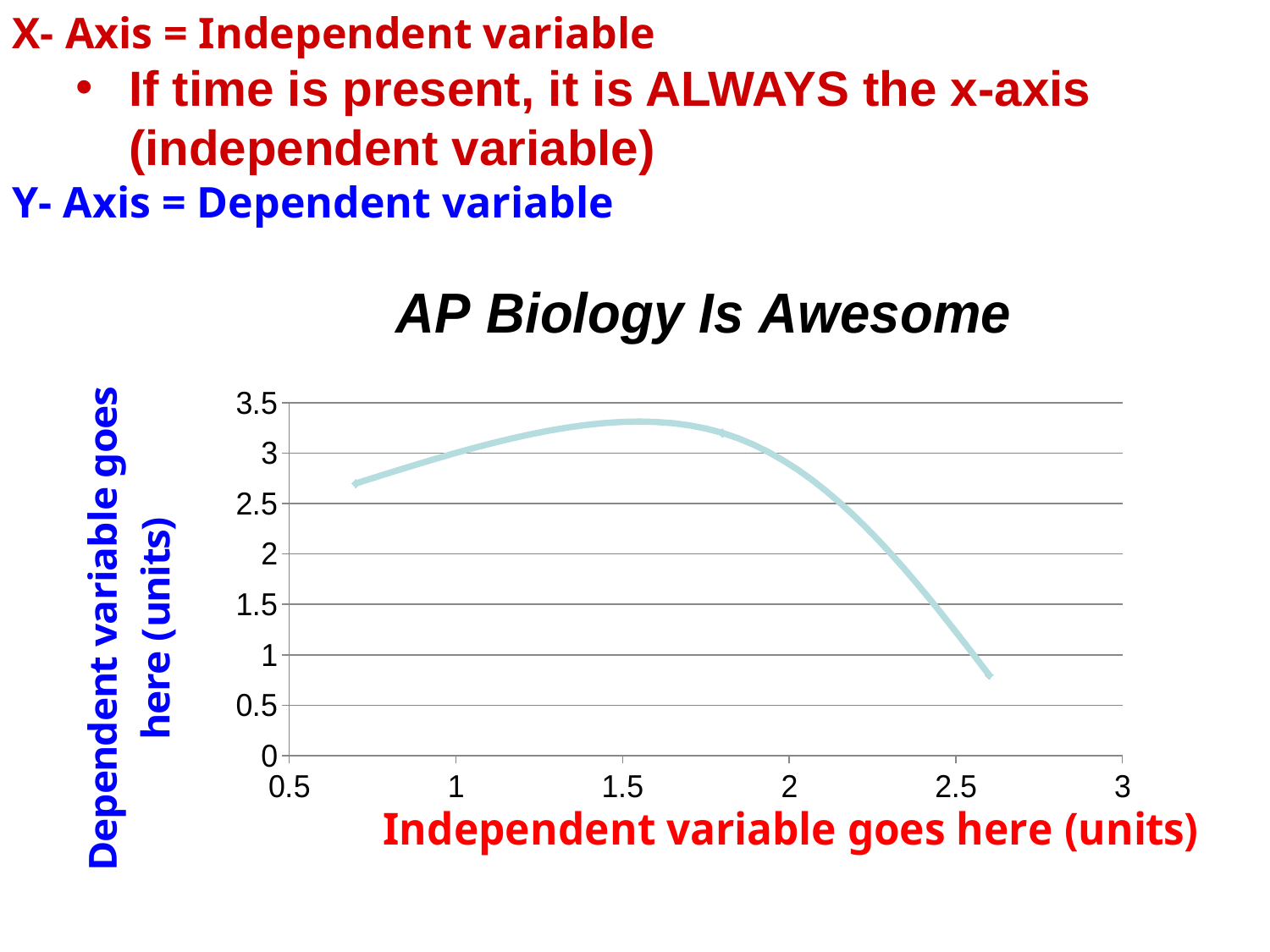
What is the x-axis title of the chart? Independent variable goes here (units) Is the value of the line at its right-hand end greater or less than 1? less Is the value of the line at x = 1.5 greater or less than 3? greater Is the value of the line at x = 2.5 greater or less than 2? less What is the title of the chart? AP Biology Is Awesome Does the line rise or fall between x = 1 and x = 1.5? rise What is the highest value labelled on the y-axis? 3.5 Does the line rise or fall between x = 2 and x = 2.5? fall Is the line's value at x = 1 larger or smaller than its value at x = 2.5? larger What kind of chart is shown under the title "AP Biology Is Awesome"? line chart